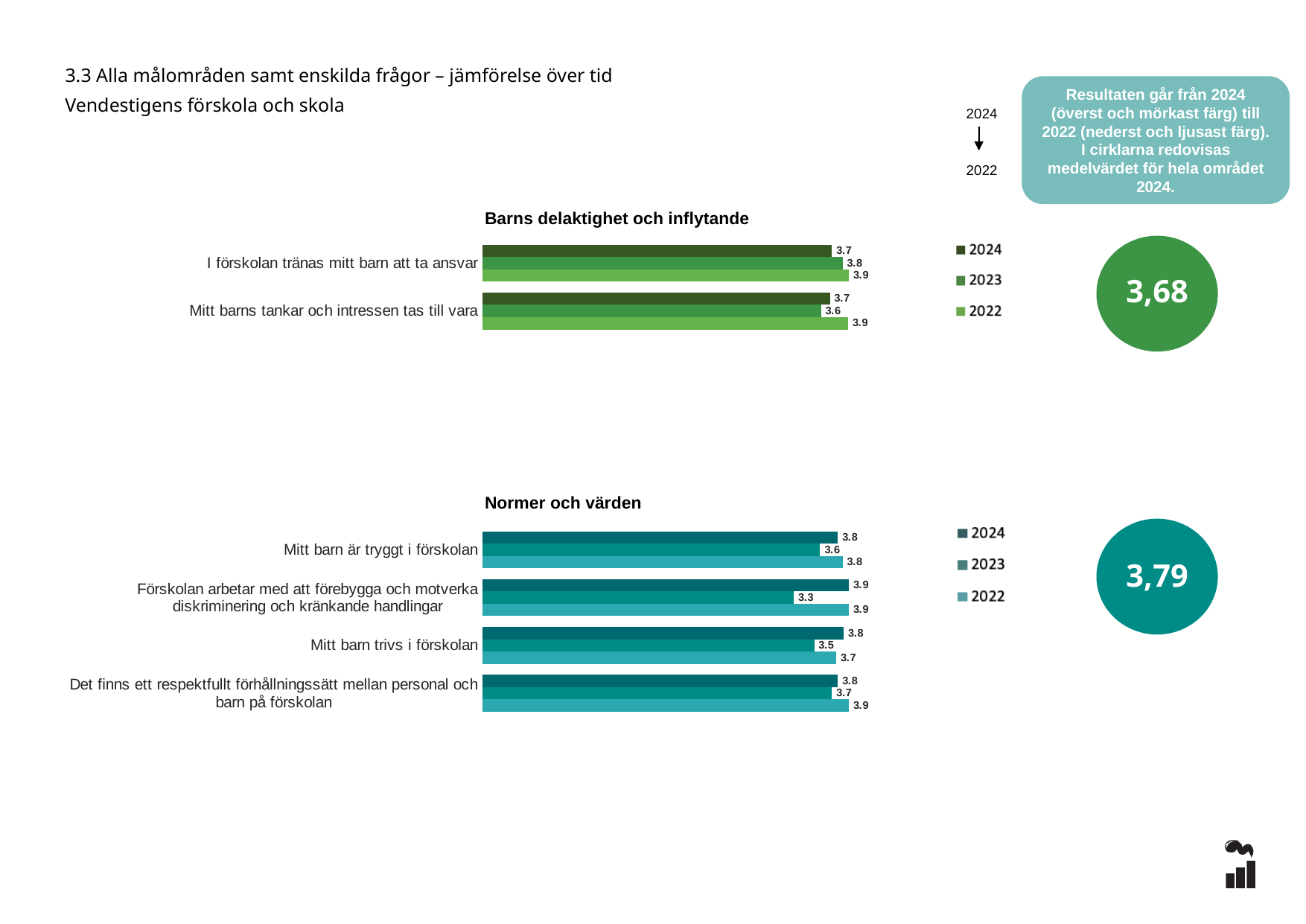
In the 'Barns delaktighet och inflytande' chart, what is the 2023 value for 'Mitt barns tankar och intressen tas till vara'? 3.6 In the 'Normer och värden' chart, which is larger for 'Mitt barn är tryggt i förskolan': the 2024 value or the 2023 value? 2024 In the 'Barns delaktighet och inflytande' chart, what is the 2024 value for 'I förskolan tränas mitt barn att ta ansvar'? 3.7 In the 'Normer och värden' chart, which question has the lowest 2023 value? Förskolan arbetar med att förebygga och motverka diskriminering och kränkande handlingar In the 'Barns delaktighet och inflytande' chart, how many series does the legend list? 3 In the 'Normer och värden' chart, what is the 2022 value for 'Mitt barn trivs i förskolan'? 3.7 In the 'Normer och värden' chart, how many questions (categories) are shown? 4 In the 'Normer och värden' chart, what is the 2023 value for 'Förskolan arbetar med att förebygga och motverka diskriminering och kränkande handlingar'? 3.3 What type of chart is 'Normer och värden'? Bar chart In the 'Barns delaktighet och inflytande' chart, what is the difference between the 2022 and 2024 values for 'I förskolan tränas mitt barn att ta ansvar'? 0.2 In the 'Normer och värden' chart, what is the difference between the 2024 and 2023 values for 'Mitt barn trivs i förskolan'? 0.3 What is the mean value shown in the circle next to the 'Normer och värden' chart? 3,79